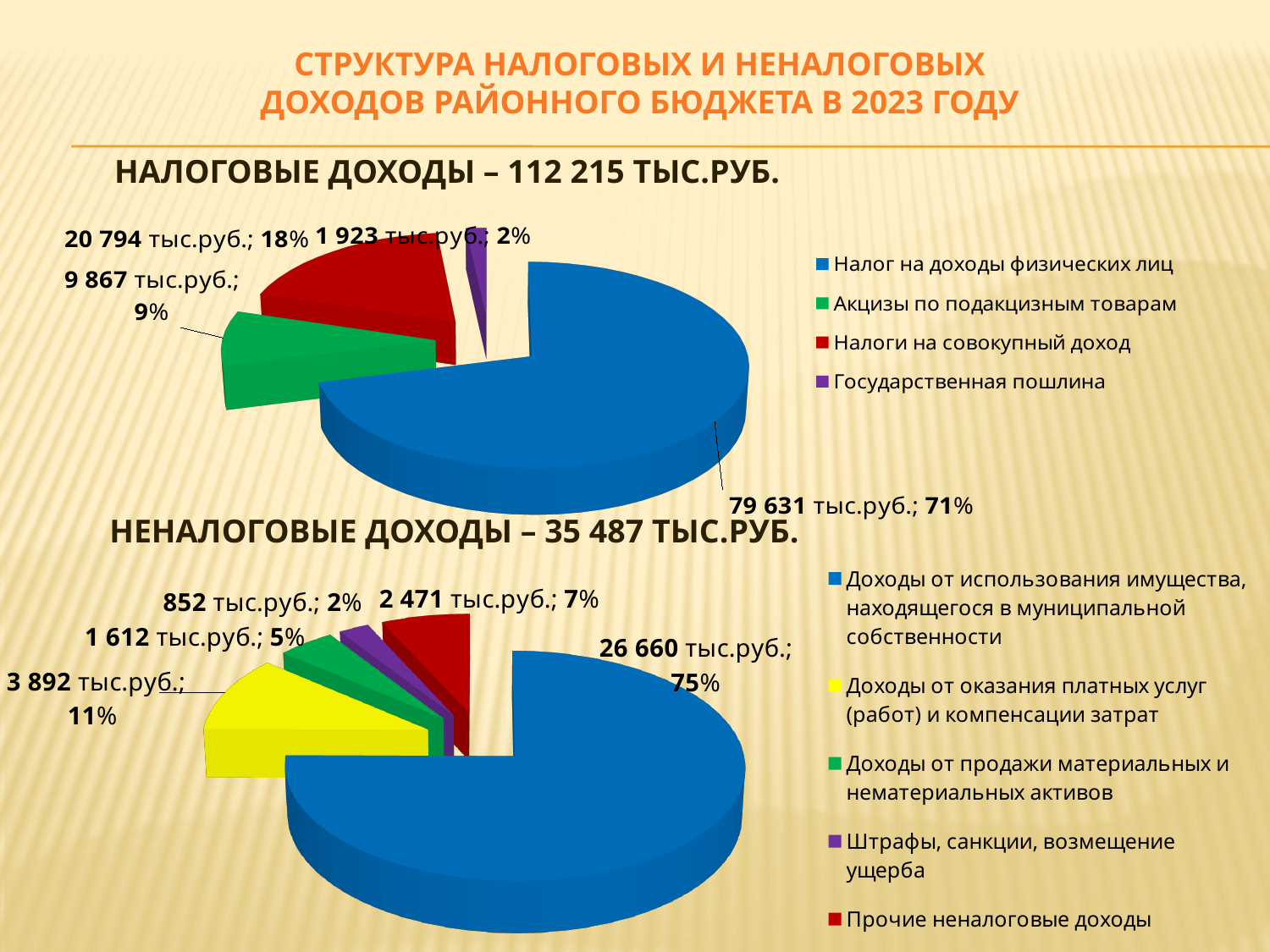
What kind of chart is used for the 'Налоговые доходы' section of the slide? Pie chart In the 'Неналоговые доходы' pie chart, what share of the pie does 'Штрафы, санкции, возмещение ущерба' have? 2% In the 'Налоговые доходы' pie chart, what value is shown for 'Налог на доходы физических лиц'? 79 631 тыс.руб.; 71% In the 'Неналоговые доходы' pie chart, how many slices are there? 5 In the 'Налоговые доходы' pie chart, what share of the pie does 'Налоги на совокупный доход' have? 18% In the 'Налоговые доходы' pie chart, which category has the smallest slice? Государственная пошлина In the 'Неналоговые доходы' pie chart, what value is shown for 'Доходы от оказания платных услуг (работ) и компенсации затрат'? 3 892 тыс.руб.; 11% In the 'Неналоговые доходы' pie chart, which is larger: 'Прочие неналоговые доходы' or 'Доходы от продажи материальных и нематериальных активов'? Прочие неналоговые доходы In the 'Неналоговые доходы' pie chart, which category has the largest slice? Доходы от использования имущества, находящегося в муниципальной собственности In the 'Налоговые доходы' pie chart, how many categories does the legend list? 4 What total is stated in the heading above the 'Неналоговые доходы' pie chart? 35 487 тыс.руб. In the 'Налоговые доходы' pie chart, what is the difference in тыс.руб. between 'Налоги на совокупный доход' and 'Акцизы по подакцизным товарам'? 10 927 тыс.руб.